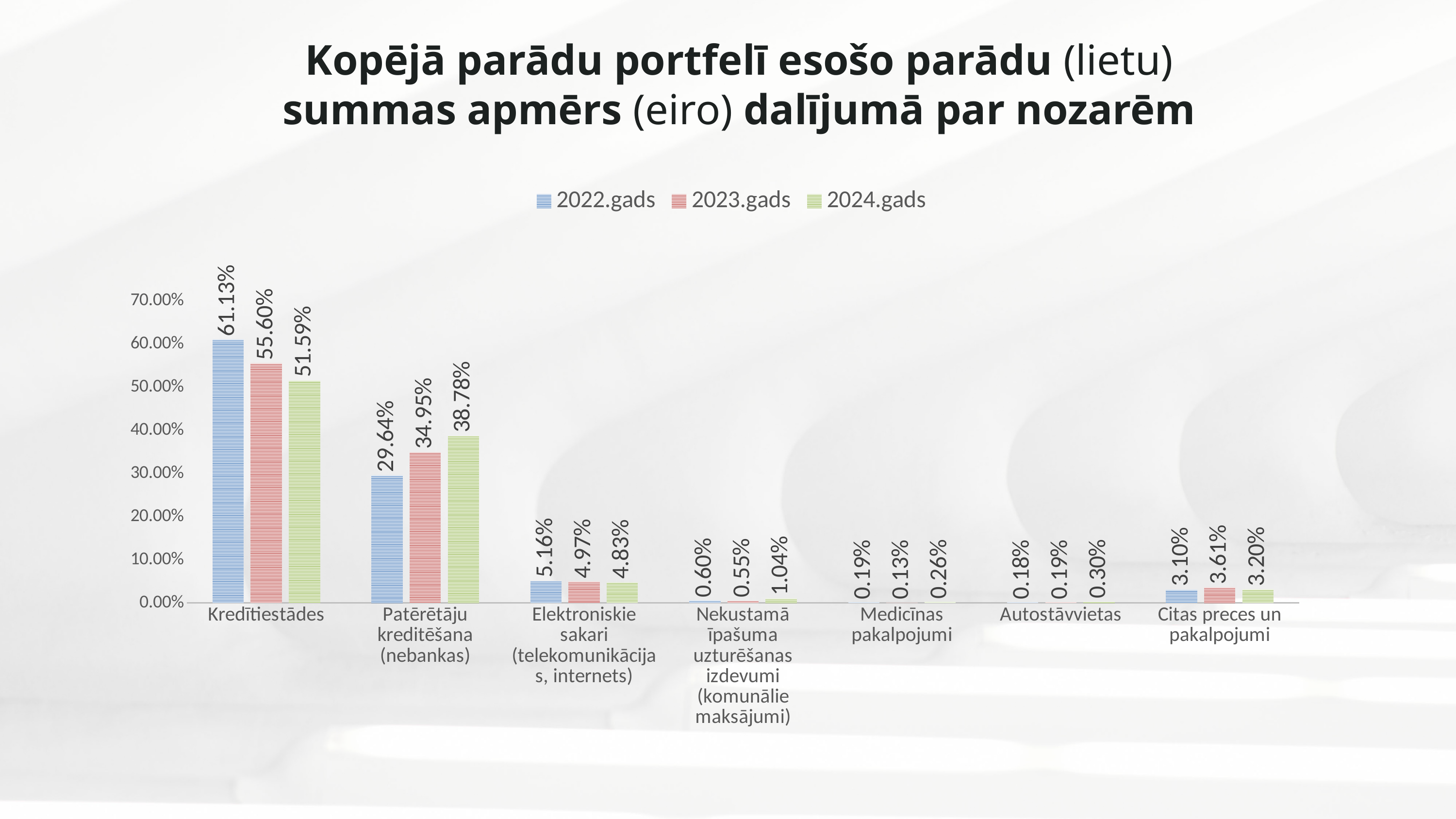
Which is larger for Citas preces un pakalpojumi: the 2023.gads value or the 2024.gads value? 2023.gads Which colour represents 2024.gads in the legend? Green What is the difference between the 2022.gads and 2024.gads values for Kredītiestādes? 9.54% What kind of chart is shown on the slide? Bar chart How many series does the legend list? 3 What is the value for Patērētāju kreditēšana (nebankas) in 2024.gads? 38.78% Do the values for Patērētāju kreditēšana (nebankas) rise or fall from 2022.gads to 2024.gads? Rise How many categories are shown on the x axis? 7 Which category has the lowest value in 2022.gads? Autostāvvietas Which category has the highest value in 2023.gads? Kredītiestādes What is the value for Autostāvvietas in 2023.gads? 0.19% What is the value for Kredītiestādes in 2022.gads? 61.13%